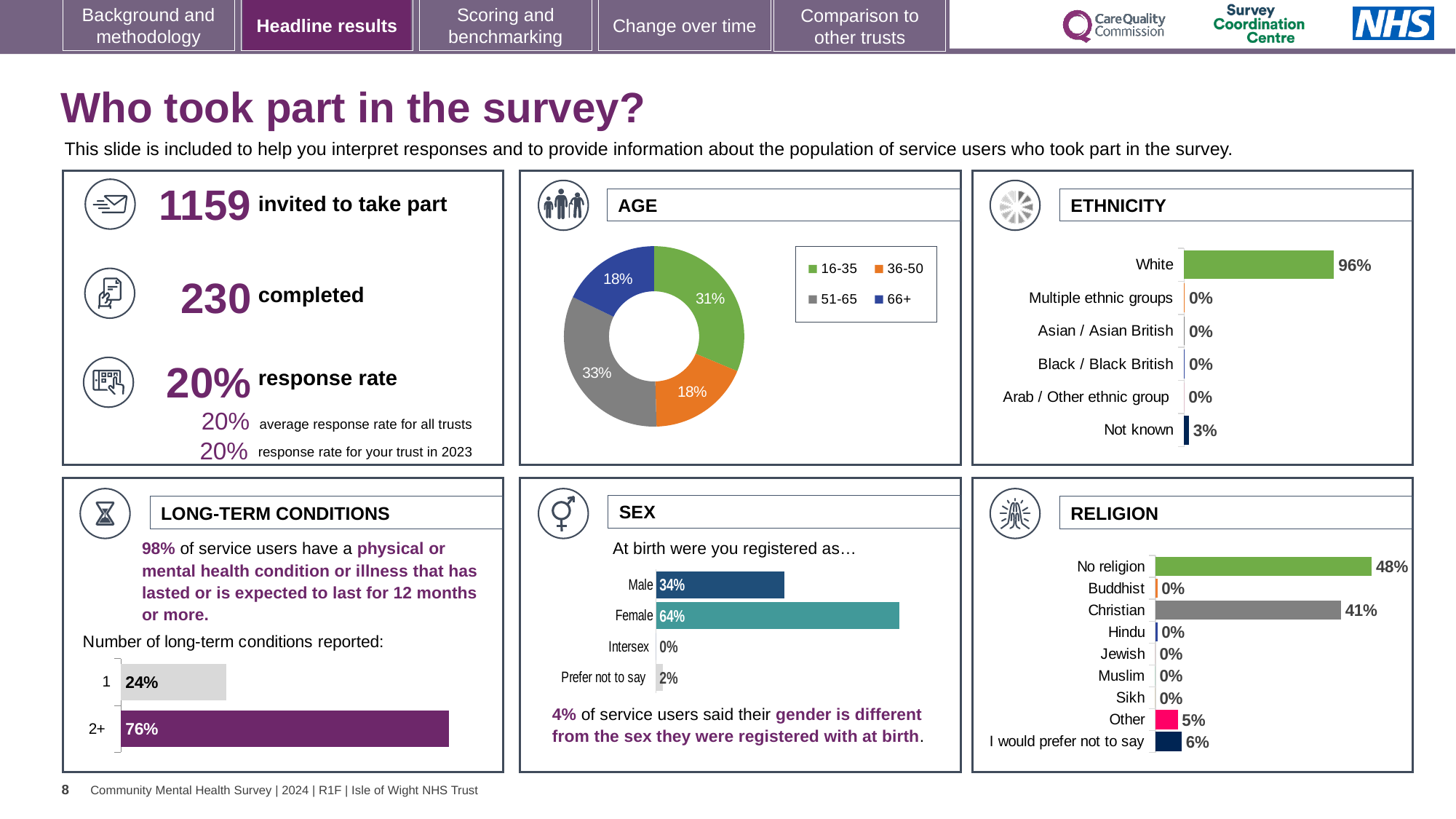
How many age groups does the legend of the AGE chart list? 4 In the AGE chart, which age group has the largest share? 51-65 In the ETHNICITY chart, what is the value for Not known? 3% How many categories are shown in the ETHNICITY chart? 6 In the ETHNICITY chart, what is the value for White? 96% In the LONG-TERM CONDITIONS chart, what percentage of service users reported 2+ long-term conditions? 76% In the AGE chart, what share of respondents are aged 16-35? 31% What kind of chart is the AGE chart? Doughnut chart In the RELIGION chart, what is the value for Christian? 41% In the RELIGION chart, which category has the highest value? No religion In the SEX chart, which is larger, Male or Female? Female In the SEX chart, what is the difference between the Female and Male values? 30%